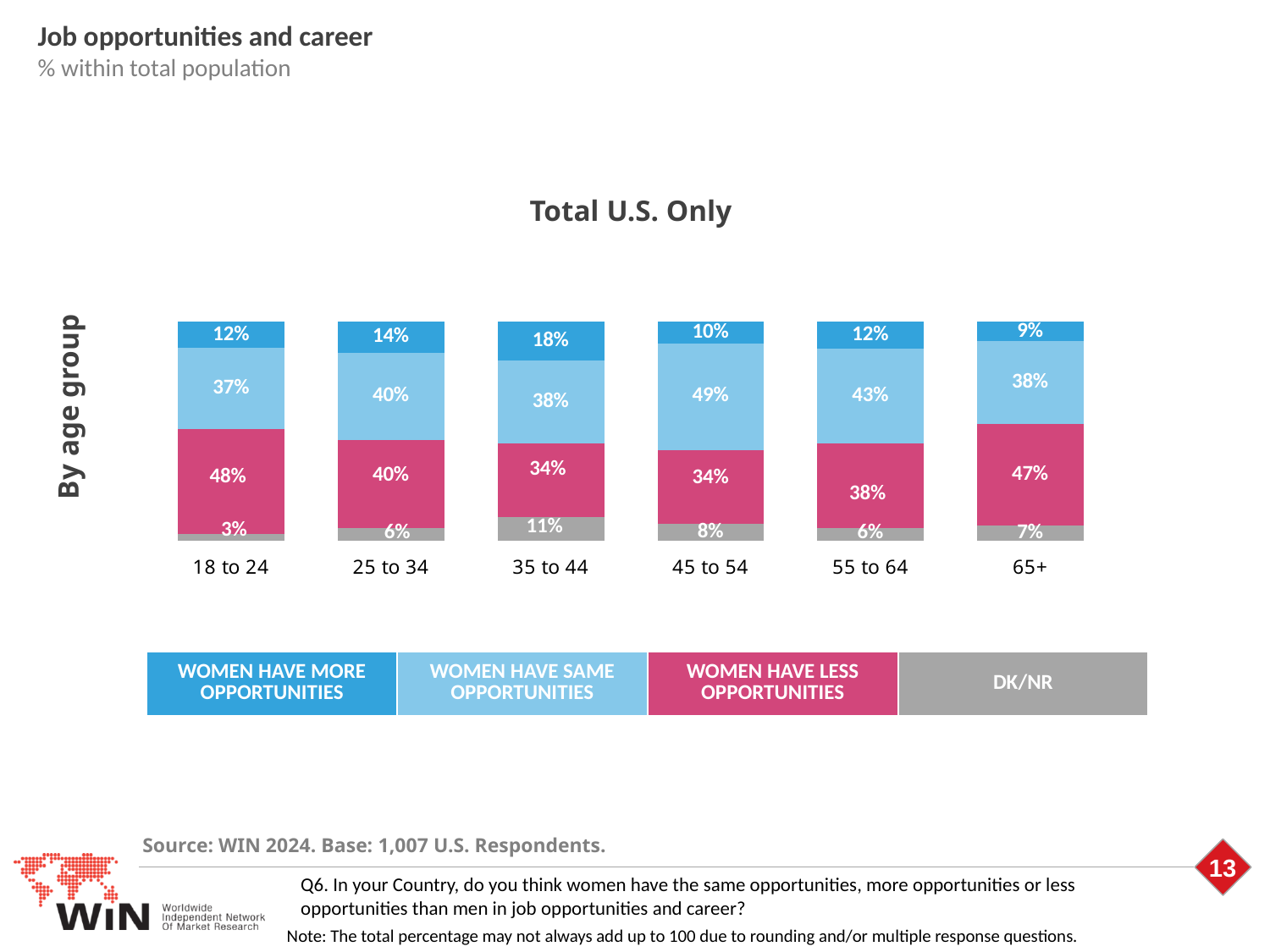
What percentage of the 65+ age group say women have more opportunities? 9% What kind of chart is shown on the slide? Stacked bar chart How many series does the legend list? 4 What percentage of the 18 to 24 age group say women have less opportunities? 48% What is the DK/NR value for the 35 to 44 age group? 11% What is the total of the stacked bar for the 25 to 34 age group? 100% How many age groups are shown on the chart? 6 What percentage of the 45 to 54 age group say women have the same opportunities? 49% Which age group has the lowest DK/NR share? 18 to 24 Which is larger: the 'women have same opportunities' value for 55 to 64 or for 65+? 55 to 64 Which age group has the highest share saying women have more opportunities? 35 to 44 What is the difference between the 'women have less opportunities' values for the 18 to 24 and 35 to 44 age groups? 14 percentage points